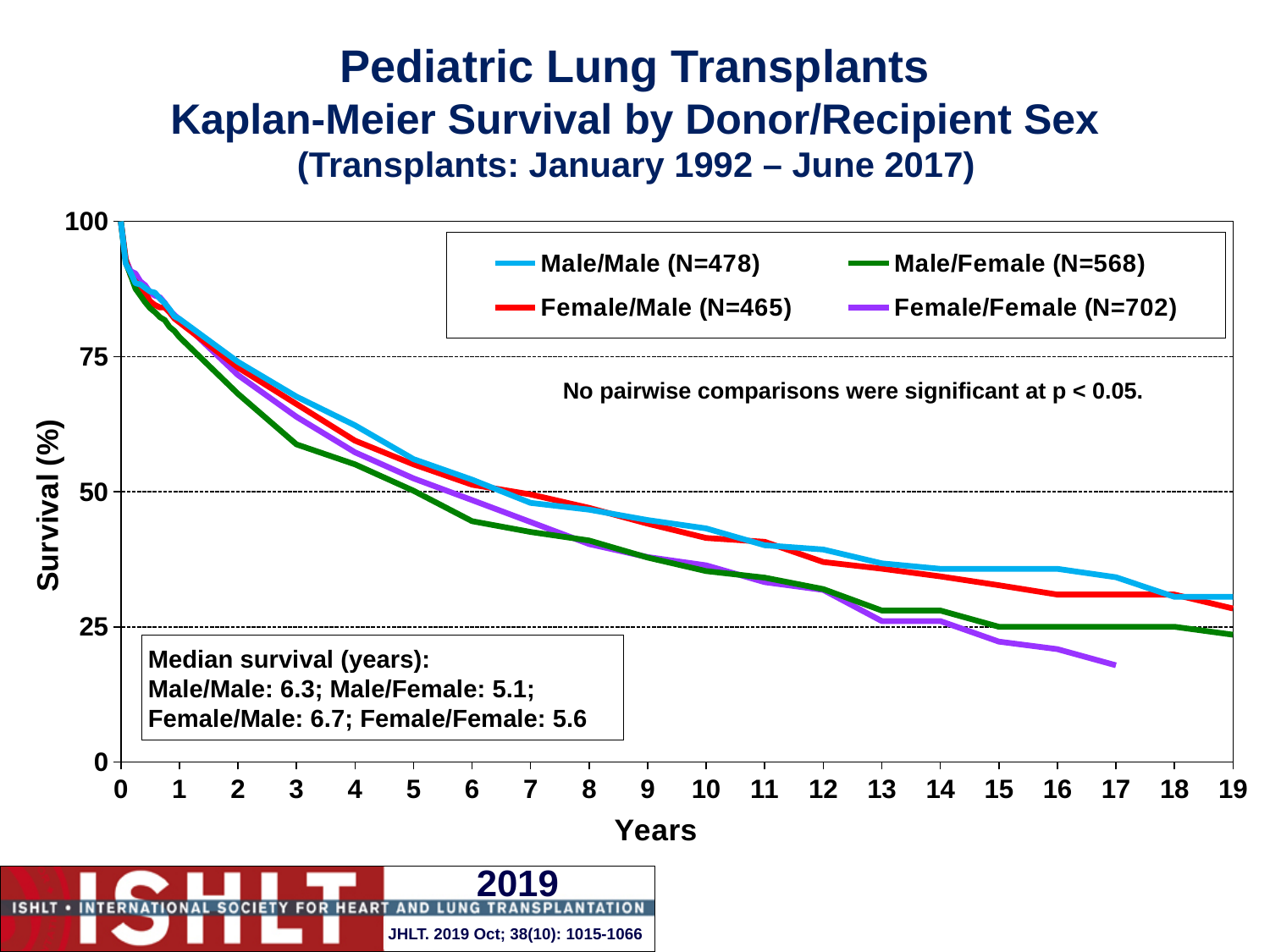
Which group has a larger median survival, Male/Male or Female/Female? Male/Male Do the survival curves rise or fall as years increase? fall What is the median survival in years for the Male/Female group? 5.1 What is the median survival in years for the Female/Male group? 6.7 Which donor/recipient sex group has the lowest median survival? Male/Female Is the survival value for the Male/Male curve at 10 years greater or less than 25? greater Is the survival value for the Female/Female curve at 17 years greater or less than 25? less How many series does the legend list? 4 What is the N for the Female/Female group shown in the legend? N=702 What kind of chart is shown on the slide? line chart Which donor/recipient sex group has the highest median survival? Female/Male What is the difference in median survival (years) between the Female/Male and Male/Female groups? 1.6